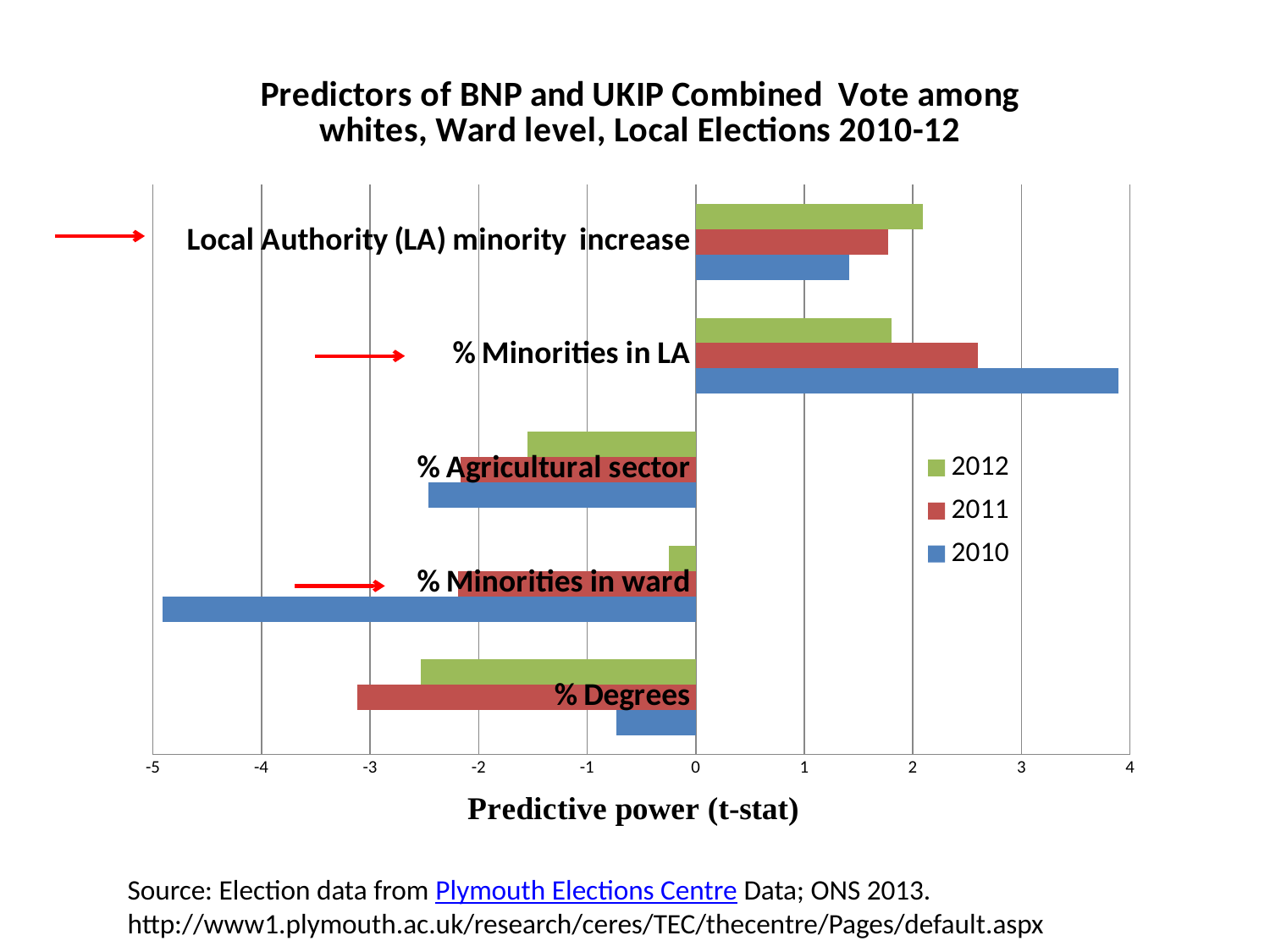
Is the 2010 value for % Minorities in ward greater or less than -4? less What kind of chart is shown on the slide? bar chart How many series does the legend list? 3 How many categories are plotted on the chart? 5 Which series has the lowest (most negative) value for % Minorities in ward? 2010 What is the label of the horizontal axis? Predictive power (t-stat) For Local Authority (LA) minority increase, which is larger: the 2012 value or the 2010 value? 2012 Which series has the highest value for % Minorities in LA? 2010 For % Degrees, which series has the value closest to zero? 2010 Is the 2012 value for Local Authority (LA) minority increase greater or less than 2? greater Is the 2011 value for % Degrees greater or less than -3? less